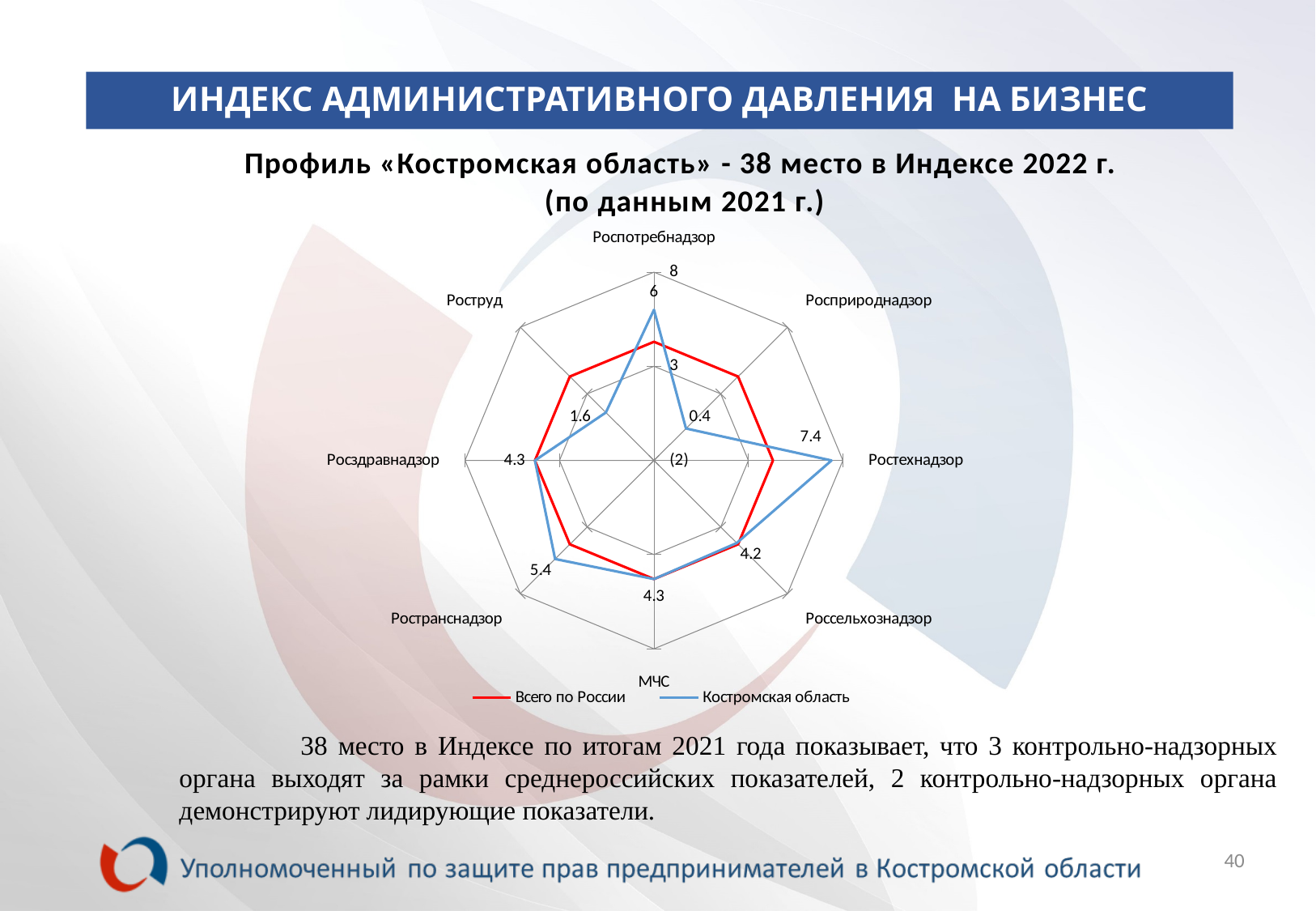
For Ростехнадзор, which series has the higher value: Всего по России or Костромская область? Костромская область For which category does Костромская область have the lowest value? Росприроднадзор Which series is drawn in red on the radar chart? Всего по России How many series does the legend of the radar chart list? 2 What is the value for Костромская область for Роспотребнадзор? 6 What type of chart is shown on the slide? Radar chart What is the value for Костромская область for Росприроднадзор? 0.4 For which category does Костромская область have the highest value? Ростехнадзор What is the difference between the Костромская область values for Ростехнадзор and Россельхознадзор? 3.2 What is the value for Костромская область for Ространснадзор? 5.4 How many categories (supervisory bodies) are plotted on the radar chart? 8 What is the value for Костромская область for Ростехнадзор? 7.4